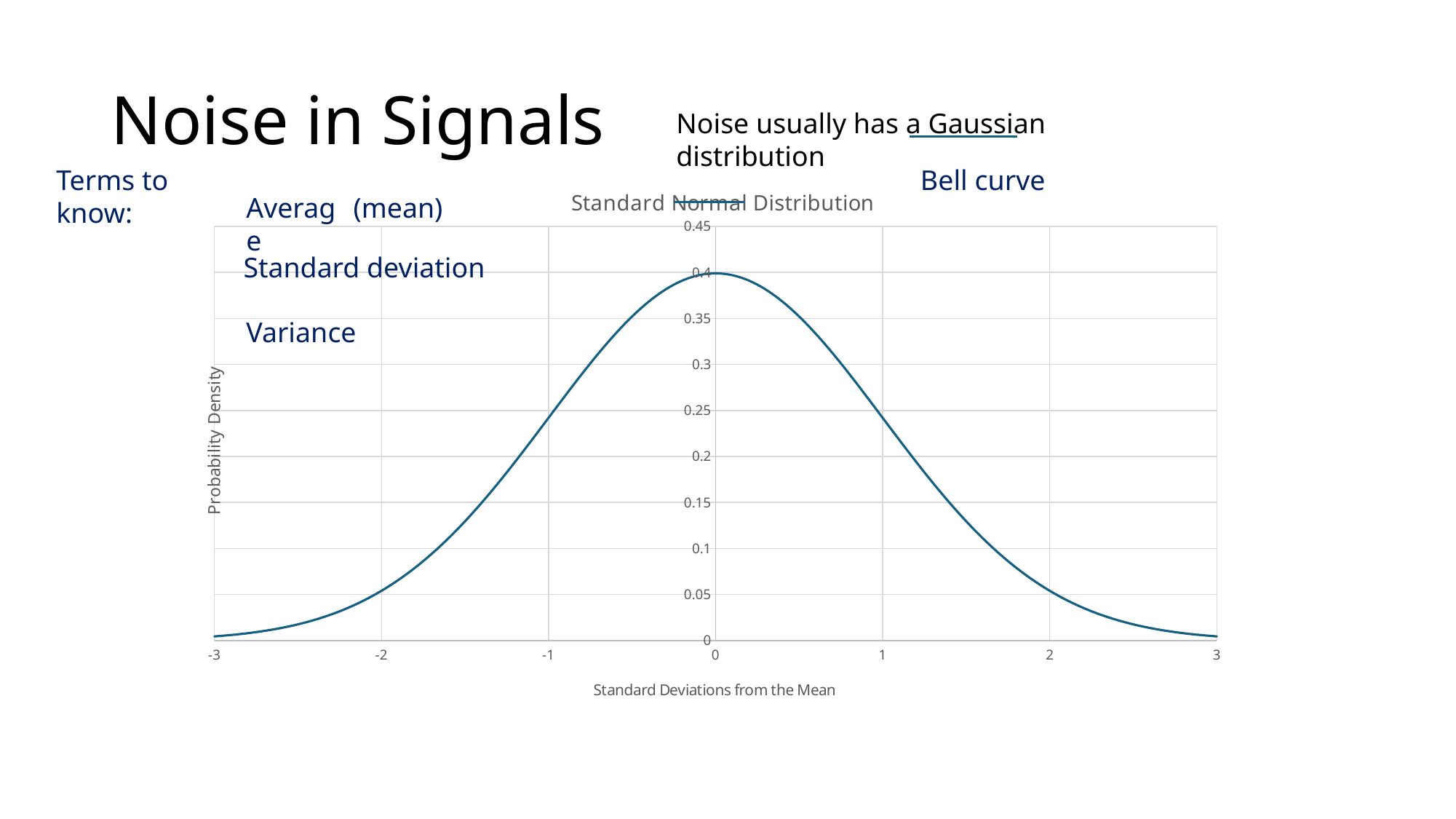
Does the curve rise or fall as the x axis goes from -3 to 0? rises At which value of standard deviations from the mean does the curve reach its highest point? 0 Is the probability density at -3 standard deviations from the mean greater or less than 0.05? less Is the probability density at 0 standard deviations from the mean greater or less than 0.35? greater Is the probability density at 2 standard deviations from the mean greater or less than 0.1? less What kind of chart is shown on the slide? line chart What is the label on the x axis of the chart? Standard Deviations from the Mean What is the title of the chart? Standard Normal Distribution Does the curve rise or fall as the x axis goes from 0 to 3? falls Which has the higher probability density: 0 or 2 standard deviations from the mean? 0